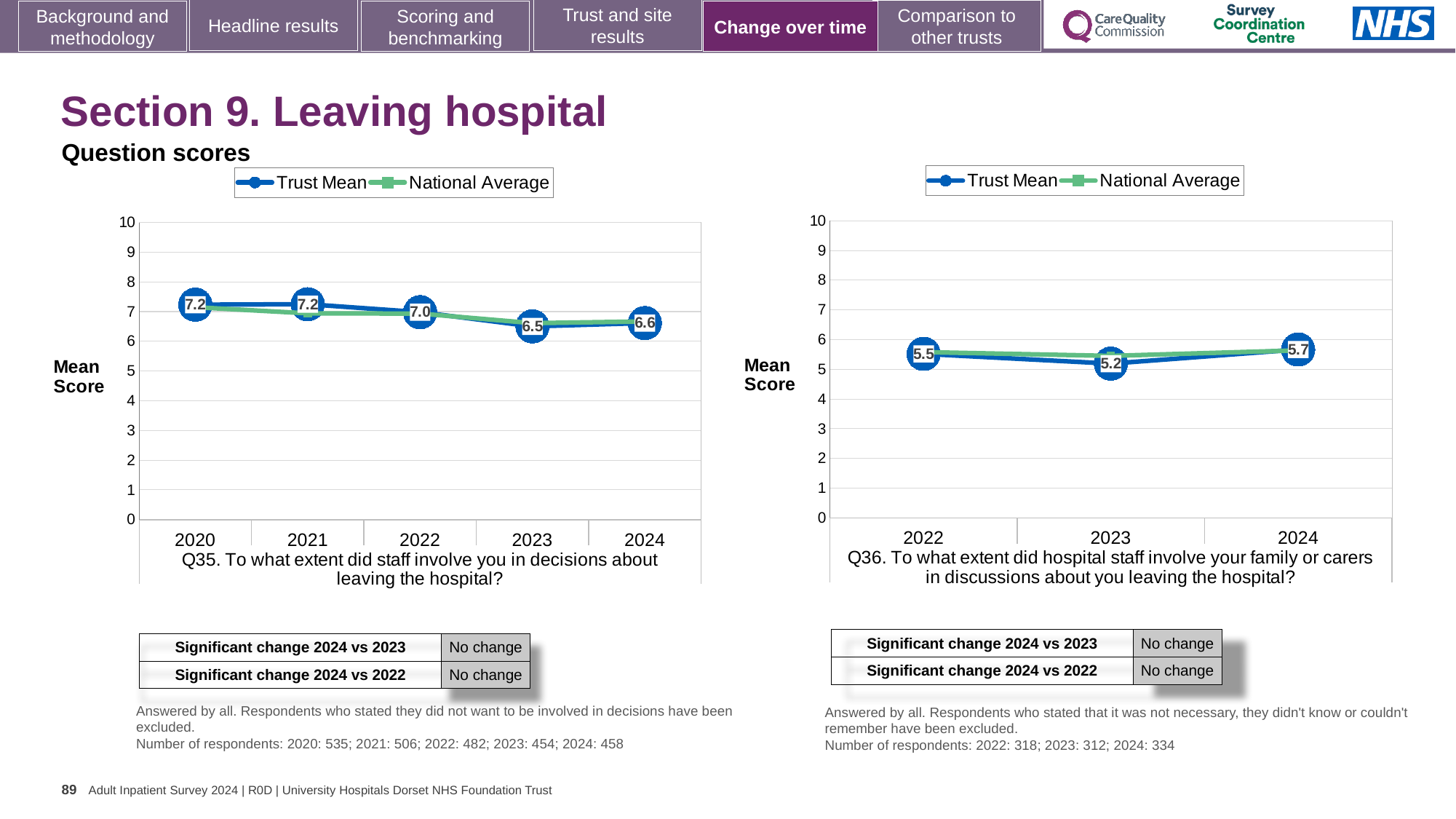
In the Q36 chart on the right, which year has the lowest Trust Mean score? 2023 In the Q36 chart on the right, is the Trust Mean score for 2022 larger or smaller than the score for 2023? larger In the Q36 chart on the right, what is the Trust Mean score for 2024? 5.7 What kind of chart is the Q35 chart on the left? Line chart How many years are plotted in the Q35 chart on the left? 5 In the Q35 chart on the left, what is the Trust Mean score for 2023? 6.5 In the Q35 chart on the left, is the National Average for 2020 greater or less than 5? greater In the Q35 chart on the left, what is the Trust Mean score for 2020? 7.2 In the Q36 chart on the right, which year has the highest Trust Mean score? 2024 How many series does the legend of the Q36 chart on the right list? 2 In the Q35 chart on the left, what is the difference between the Trust Mean scores for 2020 and 2024? 0.6 In the Q35 chart on the left, which year has the lowest Trust Mean score? 2023